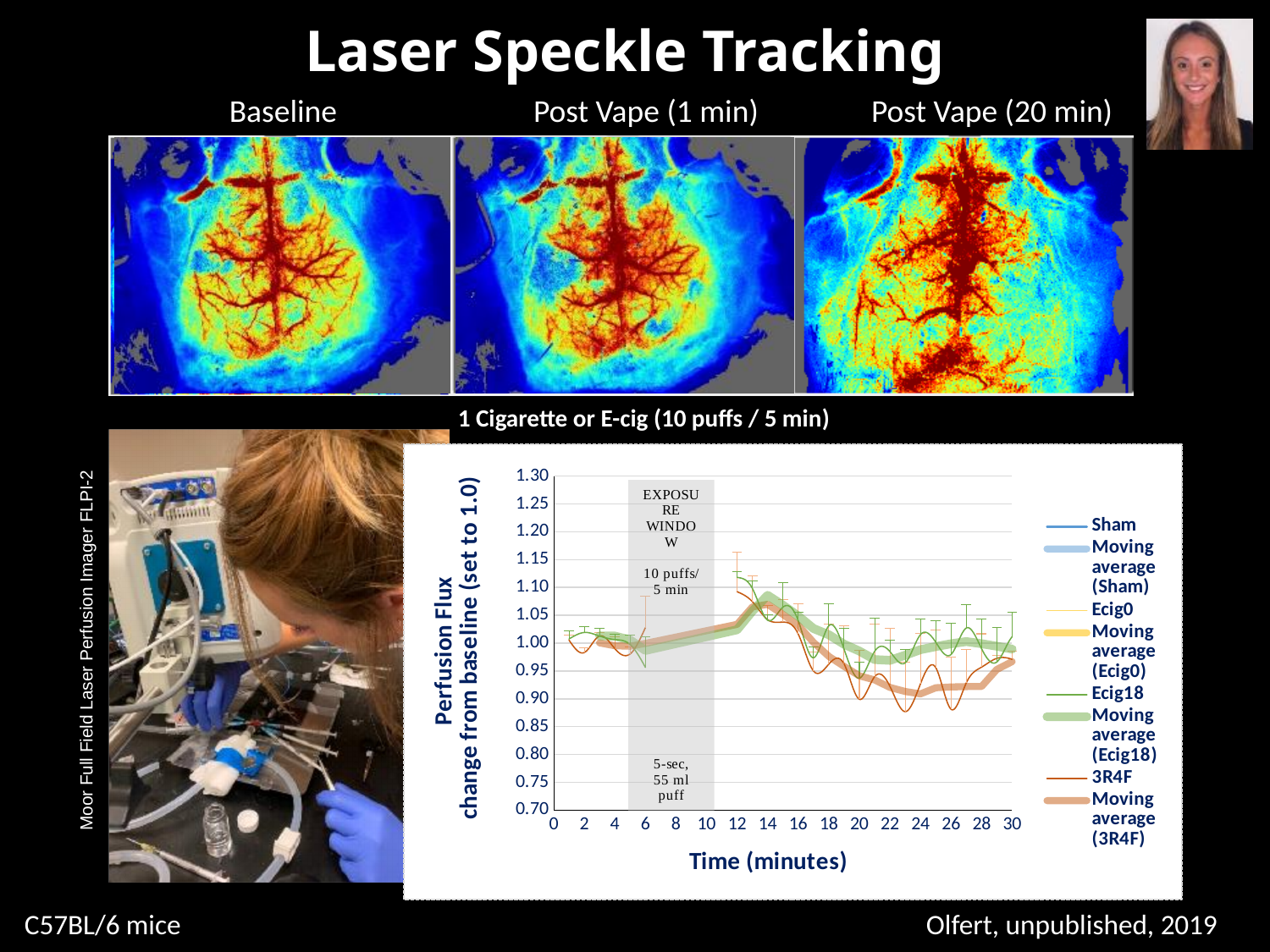
What kind of chart is shown on the slide? line chart Is the value of the Moving average (3R4F) line at 23 minutes greater or less than 0.95? less Is the value of the 3R4F line at 26 minutes greater or less than 0.95? less How many series does the chart legend list? 8 What is the label of the x axis of the chart? Time (minutes) Does the Moving average (3R4F) line rise or fall between 14 and 23 minutes? fall Is the value of the Moving average (Ecig18) line at 13 minutes greater or less than 1.00? greater What is the highest value shown on the y axis of the chart? 1.30 At 23 minutes, which is larger: the Moving average (Ecig18) value or the Moving average (3R4F) value? Moving average (Ecig18) What is the label of the y axis of the chart? Perfusion Flux change from baseline (set to 1.0) Does the Moving average (Ecig18) line rise or fall between 6 and 13 minutes? rise